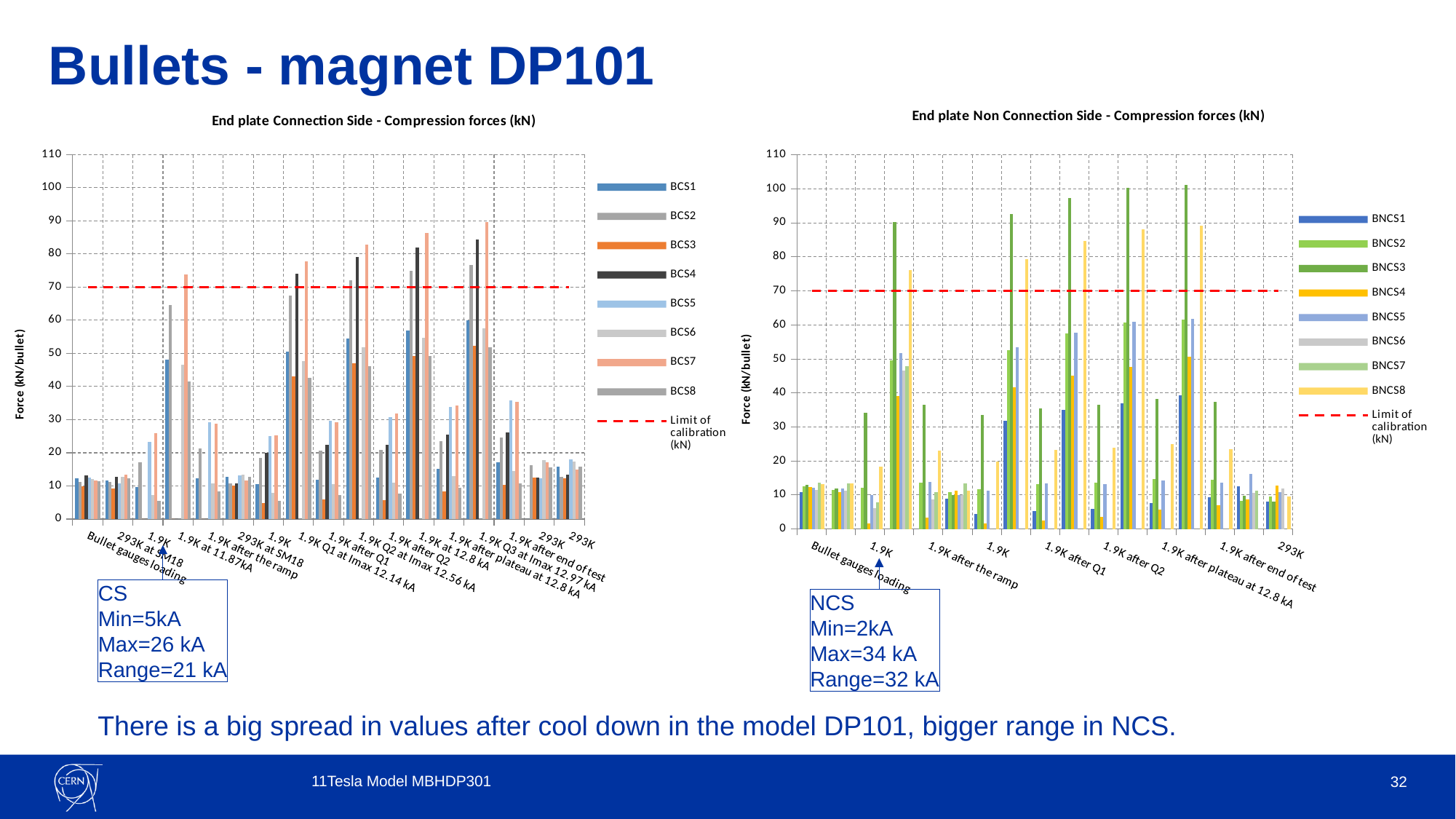
In the 'End plate Non Connection Side - Compression forces (kN)' chart, at what value is the 'Limit of calibration (kN)' dashed line drawn? 70 In the 'End plate Non Connection Side - Compression forces (kN)' chart, how many entries does the legend list? 9 In the 'End plate Non Connection Side - Compression forces (kN)' chart, which series reaches the highest value? BNCS3 In the 'End plate Connection Side - Compression forces (kN)' chart, how many BCS series does the legend list? 8 What is the y-axis label of the 'End plate Connection Side - Compression forces (kN)' chart? Force (kN/bullet) In the 'End plate Connection Side - Compression forces (kN)' chart, are all the bars for 'Bullet gauges loading' greater or less than 20? less What kind of chart is the 'End plate Connection Side - Compression forces (kN)' chart? bar chart What is the highest tick value on the y-axis of the 'End plate Non Connection Side - Compression forces (kN)' chart? 110 In the 'End plate Non Connection Side - Compression forces (kN)' chart, are all the bars for 'Bullet gauges loading' greater or less than 20? less In the 'End plate Non Connection Side - Compression forces (kN)' chart, is the tallest bar greater or less than 90? greater In the 'End plate Connection Side - Compression forces (kN)' chart, which series reaches the highest value? BCS7 In the 'End plate Connection Side - Compression forces (kN)' chart, at what value is the 'Limit of calibration (kN)' dashed line drawn? 70